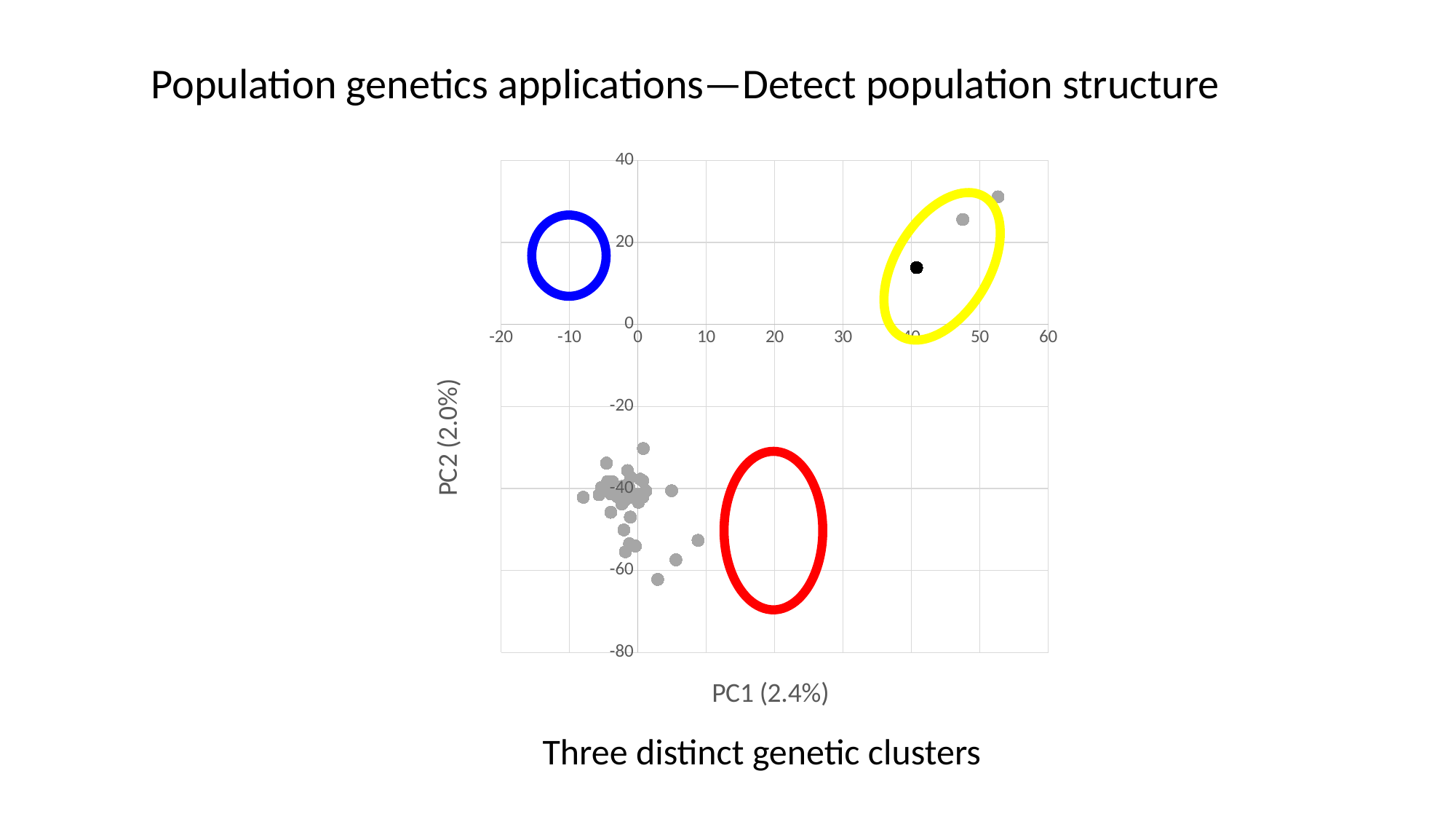
How many distinct genetic clusters does the slide say the chart shows? 3 Are the PC2 values of the large gray cluster near the bottom left greater or less than -20? less Is the PC1 value of the black point greater or less than 30? greater Which has the larger PC2 value: the black point or the points in the large gray cluster at the bottom left? the black point What kind of chart is shown on the slide? scatter plot Is the PC2 value of the topmost gray point in the upper right greater or less than 20? greater What is the highest tick value shown on the x axis? 60 What is the label of the y axis of the chart? PC2 (2.0%) What is the label of the x axis of the chart? PC1 (2.4%) What is the lowest tick value shown on the y axis? -80